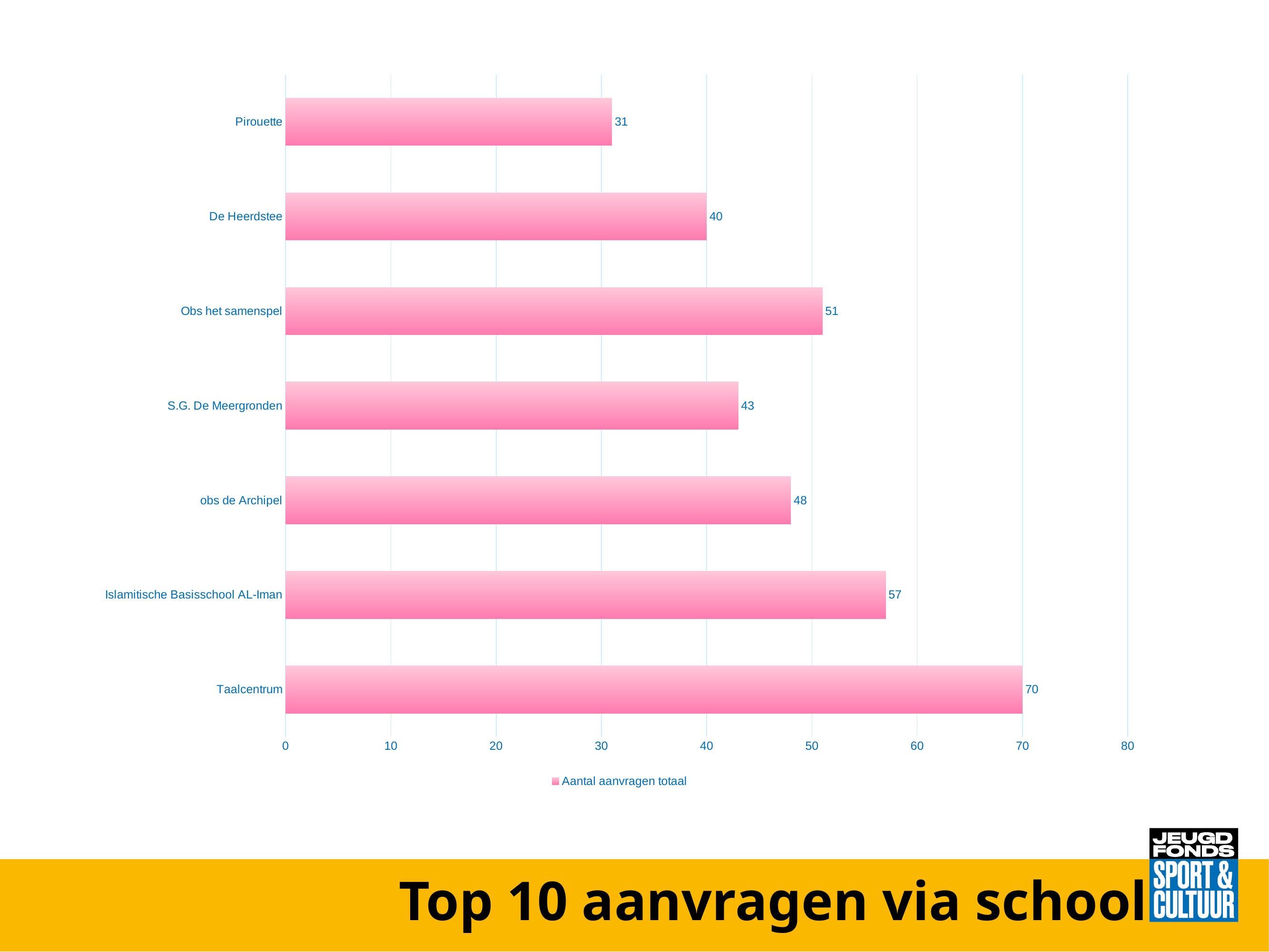
Which school has the highest number of aanvragen? Taalcentrum Is the value for De Heerdstee greater or less than 50? less What kind of chart is shown on the slide? bar chart What is the value for Taalcentrum? 70 What is the value for S.G. De Meergronden? 43 Which is larger, the value for Obs het samenspel or the value for obs de Archipel? Obs het samenspel Which school has the lowest number of aanvragen? Pirouette What is the difference between the values for Taalcentrum and Islamitische Basisschool AL-Iman? 13 What is the value for Pirouette? 31 What is the value for Islamitische Basisschool AL-Iman? 57 What is the legend entry for the series shown in the chart? Aantal aanvragen totaal How many schools are shown in the chart? 7